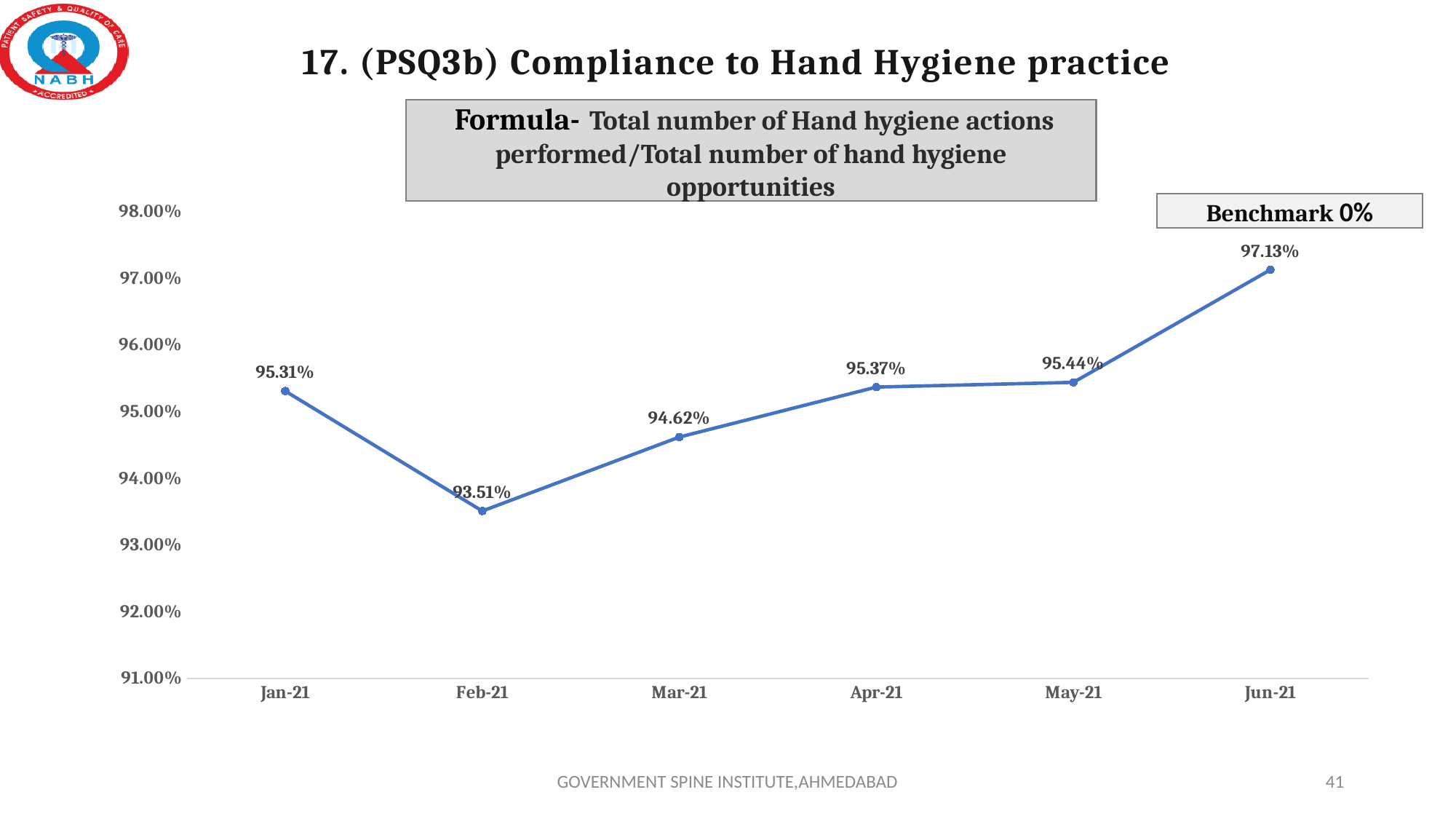
Is the value for Feb-21 greater or less than 94.00%? less Which month has the highest hand hygiene compliance? Jun-21 Do the compliance values rise or fall from Feb-21 to Jun-21? rise Which month has the lowest hand hygiene compliance? Feb-21 What is the hand hygiene compliance value for Feb-21? 93.51% How many months are plotted on the chart? 6 What is the hand hygiene compliance value for Jan-21? 95.31% What is the difference between the Jun-21 and Feb-21 compliance values? 3.62% Which is larger, the compliance value for Mar-21 or for Apr-21? Apr-21 What is the hand hygiene compliance value for Jun-21? 97.13% What kind of chart is shown on the slide? line chart What benchmark value is stated on the slide? 0%